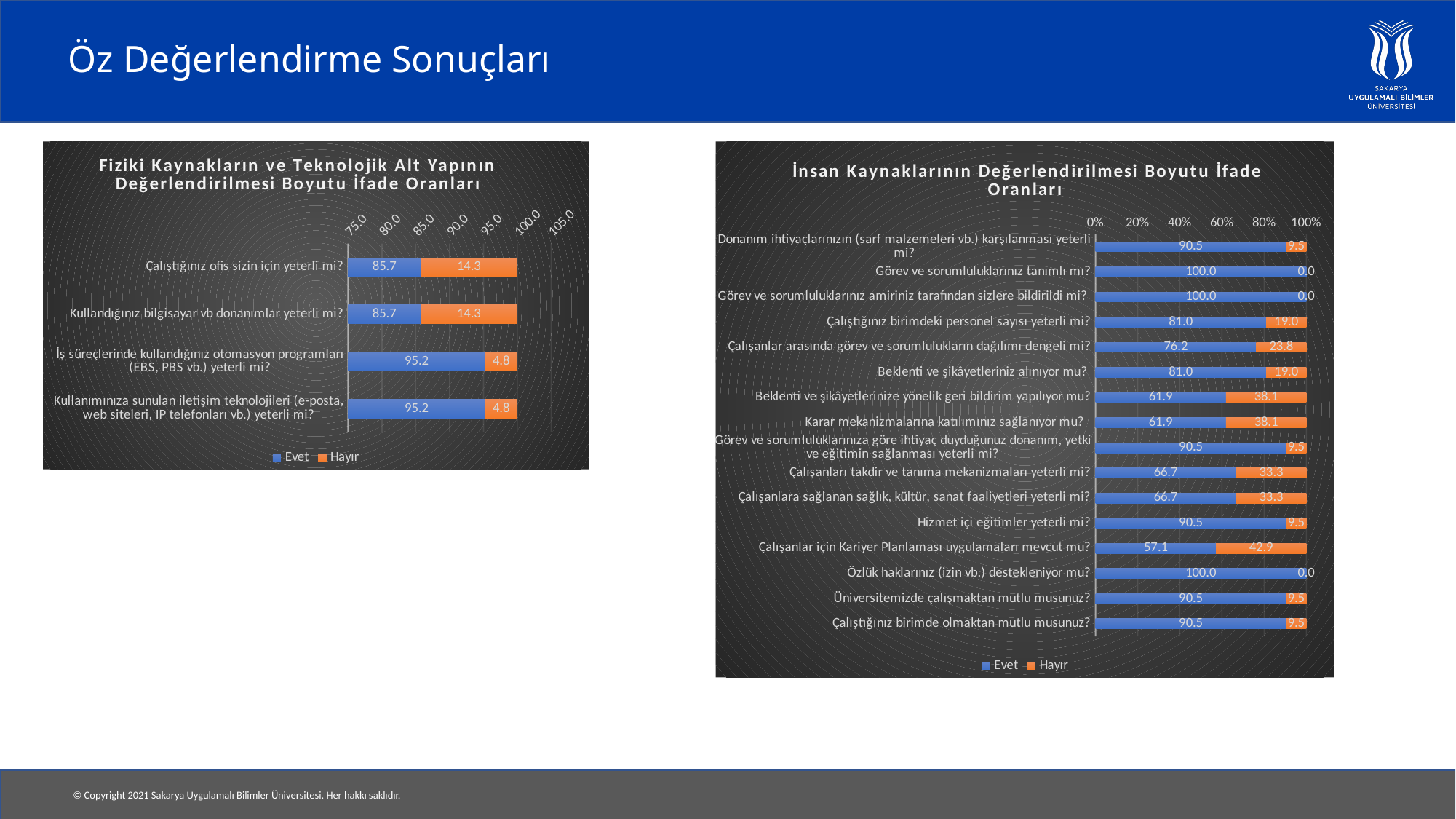
In the left chart (Fiziki Kaynakların ve Teknolojik Alt Yapının Değerlendirilmesi Boyutu İfade Oranları), what is the Hayır value for "İş süreçlerinde kullandığınız otomasyon programları (EBS, PBS vb.) yeterli mi?"? 4.8 In the right chart (İnsan Kaynaklarının Değerlendirilmesi Boyutu İfade Oranları), how many series does the legend list? 2 In the left chart (Fiziki Kaynakların ve Teknolojik Alt Yapının Değerlendirilmesi Boyutu İfade Oranları), what is the Evet value for "Çalıştığınız ofis sizin için yeterli mi?"? 85.7 In the right chart (İnsan Kaynaklarının Değerlendirilmesi Boyutu İfade Oranları), how many categories are plotted? 16 In the right chart (İnsan Kaynaklarının Değerlendirilmesi Boyutu İfade Oranları), what is the Hayır value for "Çalışanlar için Kariyer Planlaması uygulamaları mevcut mu?"? 42.9 What type of chart is the left chart (Fiziki Kaynakların ve Teknolojik Alt Yapının Değerlendirilmesi Boyutu İfade Oranları)? Stacked bar chart In the left chart (Fiziki Kaynakların ve Teknolojik Alt Yapının Değerlendirilmesi Boyutu İfade Oranları), how many categories are plotted? 4 In the left chart (Fiziki Kaynakların ve Teknolojik Alt Yapının Değerlendirilmesi Boyutu İfade Oranları), what is the difference between the Evet and Hayır values for "Kullandığınız bilgisayar vb donanımlar yeterli mi?"? 71.4 In the right chart (İnsan Kaynaklarının Değerlendirilmesi Boyutu İfade Oranları), is the Evet value for "Karar mekanizmalarına katılımınız sağlanıyor mu?" larger or smaller than the Evet value for "Hizmet içi eğitimler yeterli mi?"? smaller In the right chart (İnsan Kaynaklarının Değerlendirilmesi Boyutu İfade Oranları), which category has the lowest Evet value? Çalışanlar için Kariyer Planlaması uygulamaları mevcut mu? In the right chart (İnsan Kaynaklarının Değerlendirilmesi Boyutu İfade Oranları), what is the Evet value for "Çalışanlar arasında görev ve sorumlulukların dağılımı dengeli mi?"? 76.2 In the right chart (İnsan Kaynaklarının Değerlendirilmesi Boyutu İfade Oranları), which category has the highest Hayır value? Çalışanlar için Kariyer Planlaması uygulamaları mevcut mu?